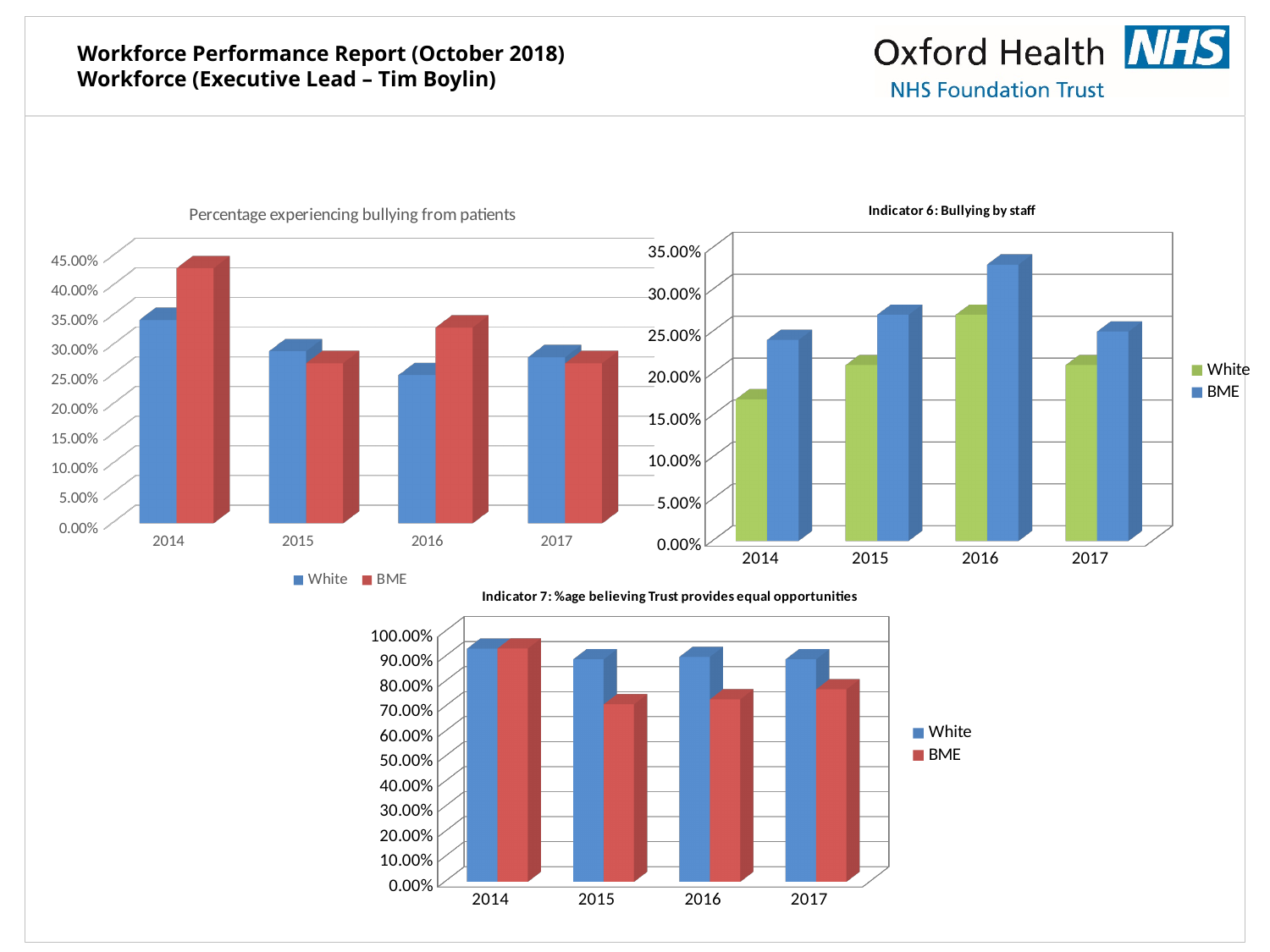
In the chart titled "Indicator 6: Bullying by staff", which year has the highest value for BME? 2016 What type of chart is the chart titled "Indicator 6: Bullying by staff"? Bar chart How many years are shown on the x axis of the chart titled "Indicator 7: %age believing Trust provides equal opportunities"? 4 In the chart titled "Indicator 7: %age believing Trust provides equal opportunities", which is larger in 2017, White or BME? White In the chart titled "Percentage experiencing bullying from patients", which year has the lowest value for White? 2016 In the chart titled "Indicator 6: Bullying by staff", is the BME value for 2016 greater or less than 30.00%? greater In the chart titled "Percentage experiencing bullying from patients", is the White value for 2016 greater or less than 30.00%? less In the chart titled "Indicator 6: Bullying by staff", which is larger in 2015, White or BME? BME In the chart titled "Percentage experiencing bullying from patients", which year has the highest value for BME? 2014 In the chart titled "Percentage experiencing bullying from patients", is the BME value for 2014 greater or less than 40.00%? greater In the chart titled "Indicator 6: Bullying by staff", which year has the lowest value for White? 2014